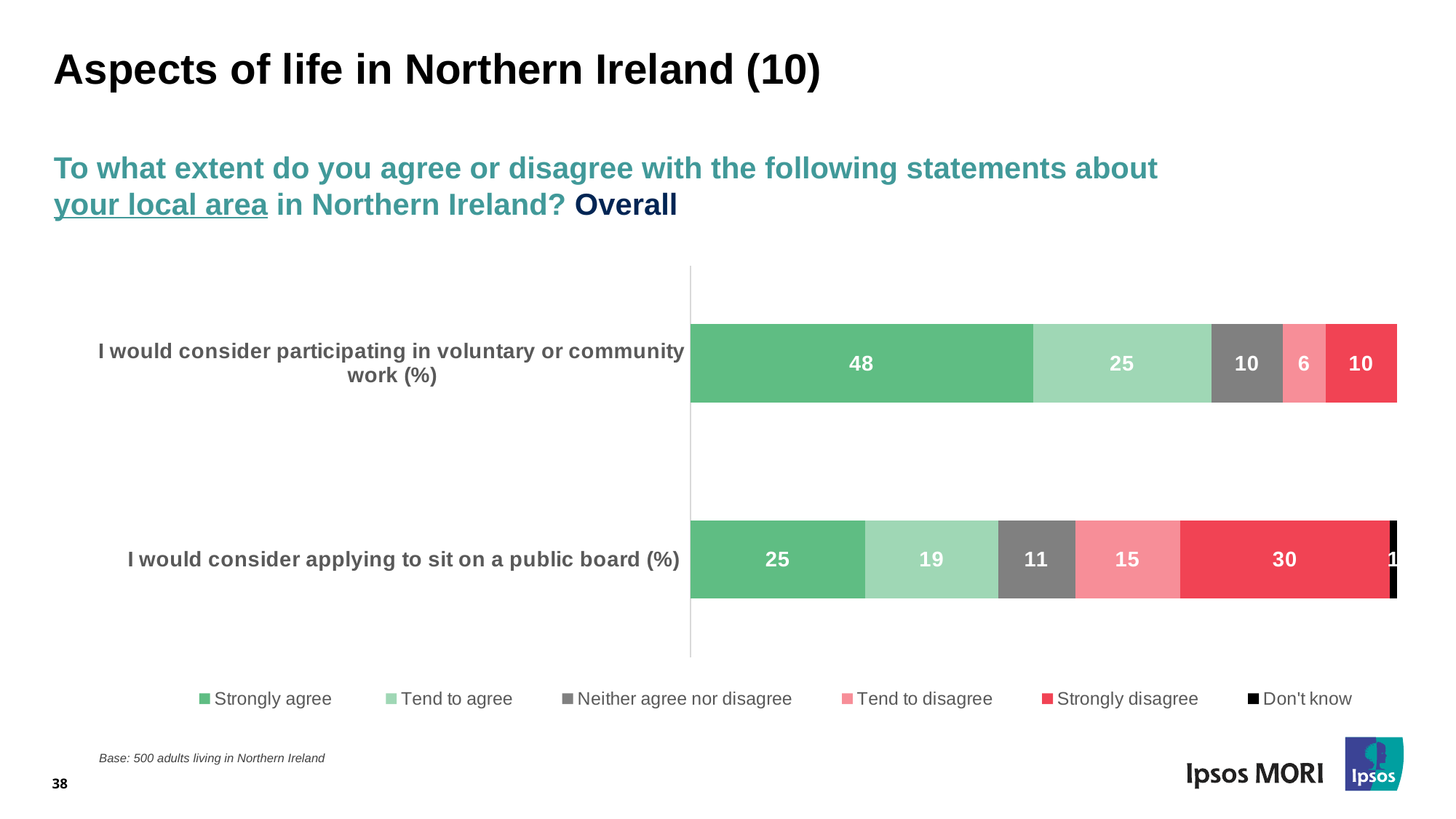
What is the difference between the 'Strongly disagree' values for the public board statement and the voluntary work statement? 20 What percentage strongly disagree that they would consider applying to sit on a public board? 30 What percentage strongly agree that they would consider participating in voluntary or community work? 48 What is the 'Neither agree nor disagree' value for 'I would consider participating in voluntary or community work (%)'? 10 Which legend entry is shown in black? Don't know What is the 'Tend to disagree' value for 'I would consider applying to sit on a public board (%)'? 15 What is the difference between the 'Strongly agree' values for the two statements? 23 Which statement has the higher 'Strongly agree' value? I would consider participating in voluntary or community work (%) Which response category has the smallest value for 'I would consider participating in voluntary or community work (%)'? Tend to disagree How many statements (categories) are shown in the chart? 2 What kind of chart is shown on the slide? Stacked bar chart How many series does the legend list? 6